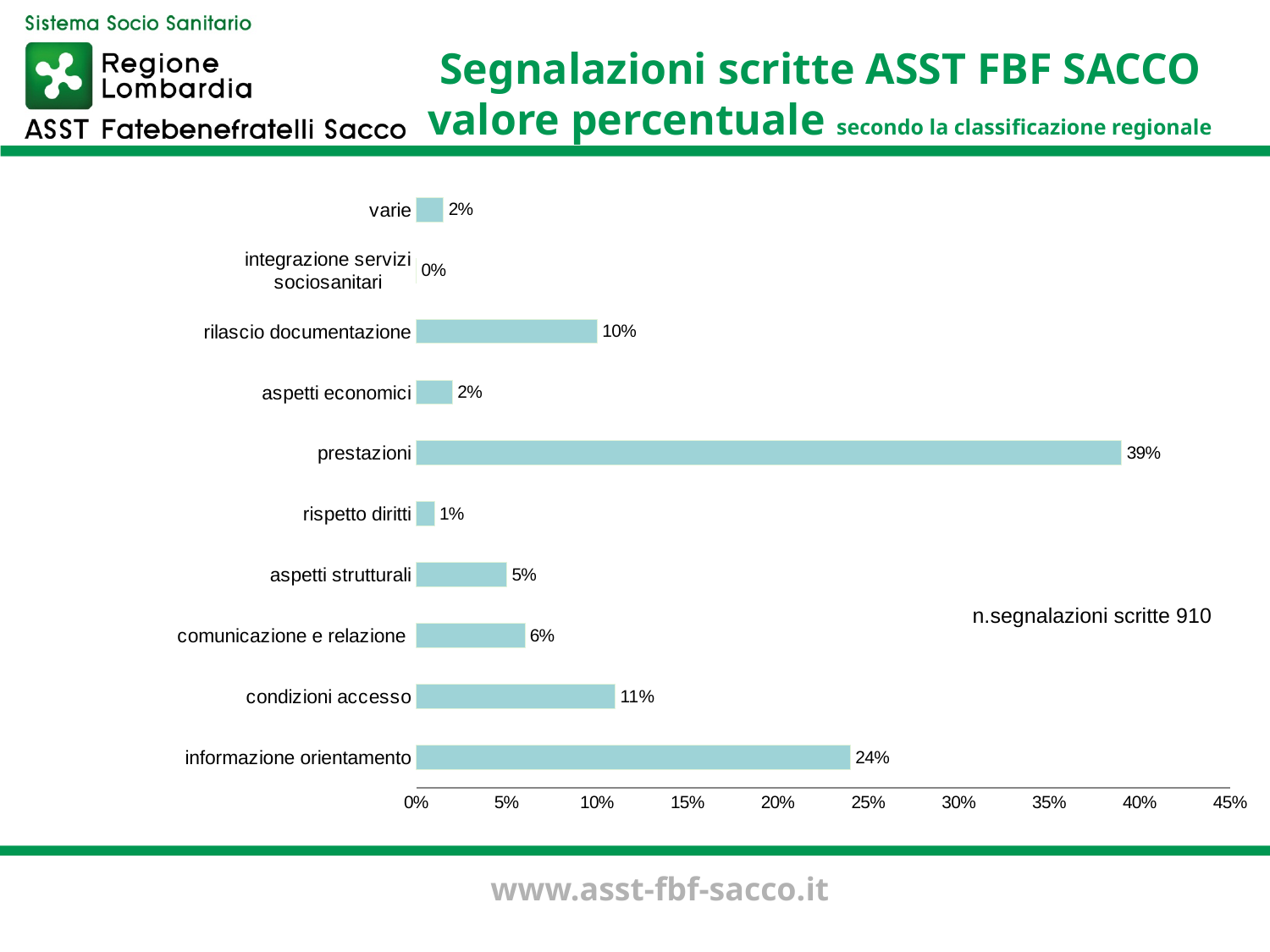
What is the difference between the values for comunicazione e relazione and aspetti strutturali? 1% Which is larger, the value for rilascio documentazione or the value for condizioni accesso? condizioni accesso What is the value for informazione orientamento? 24% What is the difference between the values for prestazioni and informazione orientamento? 15% Which category has the highest value? prestazioni What is the value for prestazioni? 39% What kind of chart is shown on the slide? bar chart Which category has the lowest value? integrazione servizi sociosanitari What is the value for condizioni accesso? 11% How many categories are shown in the chart? 10 How many written reports (segnalazioni scritte) does the slide say there were? 910 What is the value for integrazione servizi sociosanitari? 0%